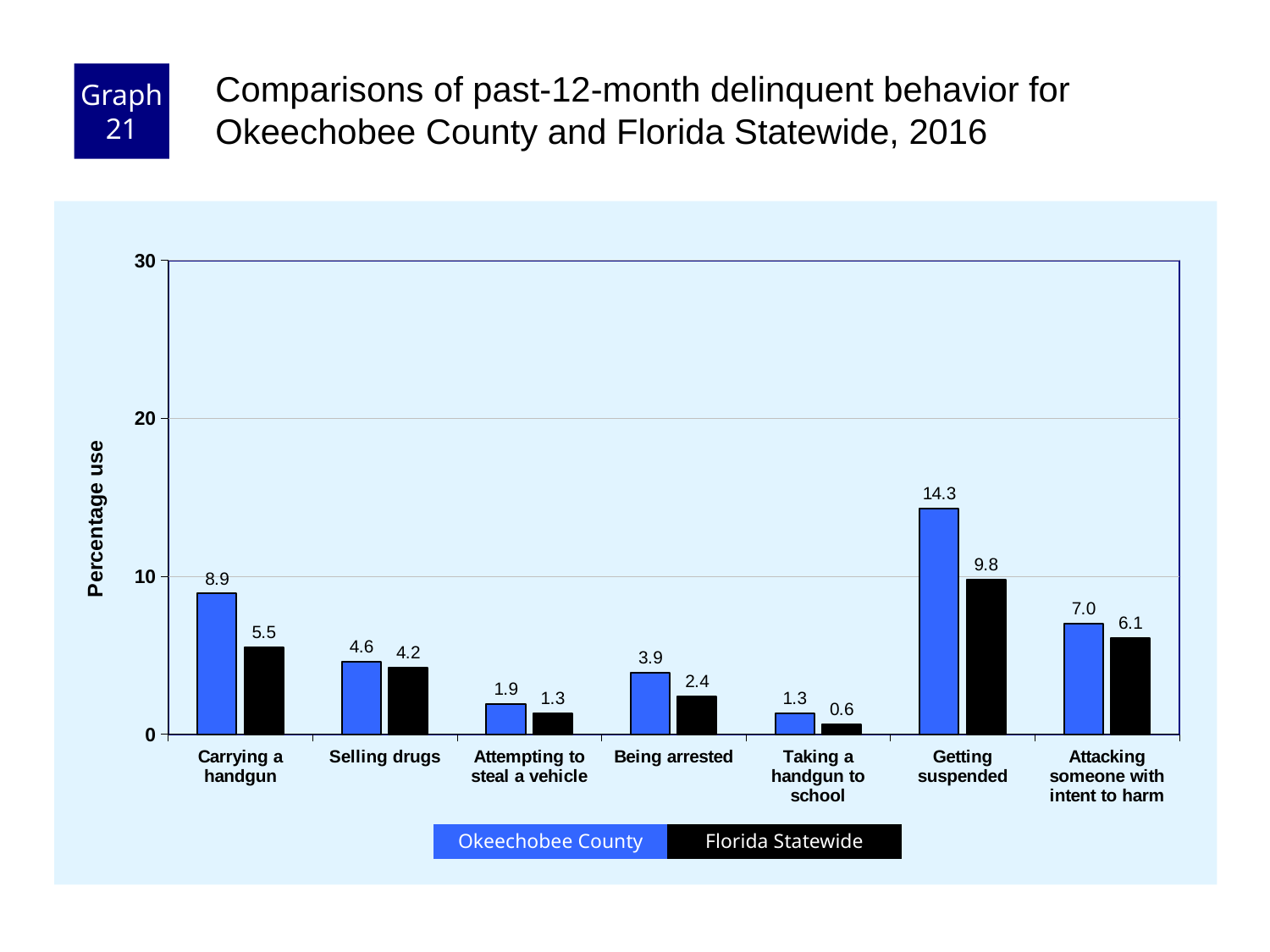
What is the difference between the Okeechobee County and Florida Statewide values for Carrying a handgun? 3.4 What is the Okeechobee County value for Taking a handgun to school? 1.3 What kind of chart is shown on the slide? bar chart Which category has the lowest Florida Statewide value? Taking a handgun to school How many categories are shown on the x axis? 7 Which category has the highest Okeechobee County value? Getting suspended Which is larger for Being arrested: the Okeechobee County value or the Florida Statewide value? Okeechobee County What is the difference between the Okeechobee County and Florida Statewide values for Getting suspended? 4.5 Is the Okeechobee County value for Getting suspended greater or less than 10? greater What is the Florida Statewide value for Carrying a handgun? 5.5 How many series does the legend list? 2 What is the Okeechobee County value for Getting suspended? 14.3